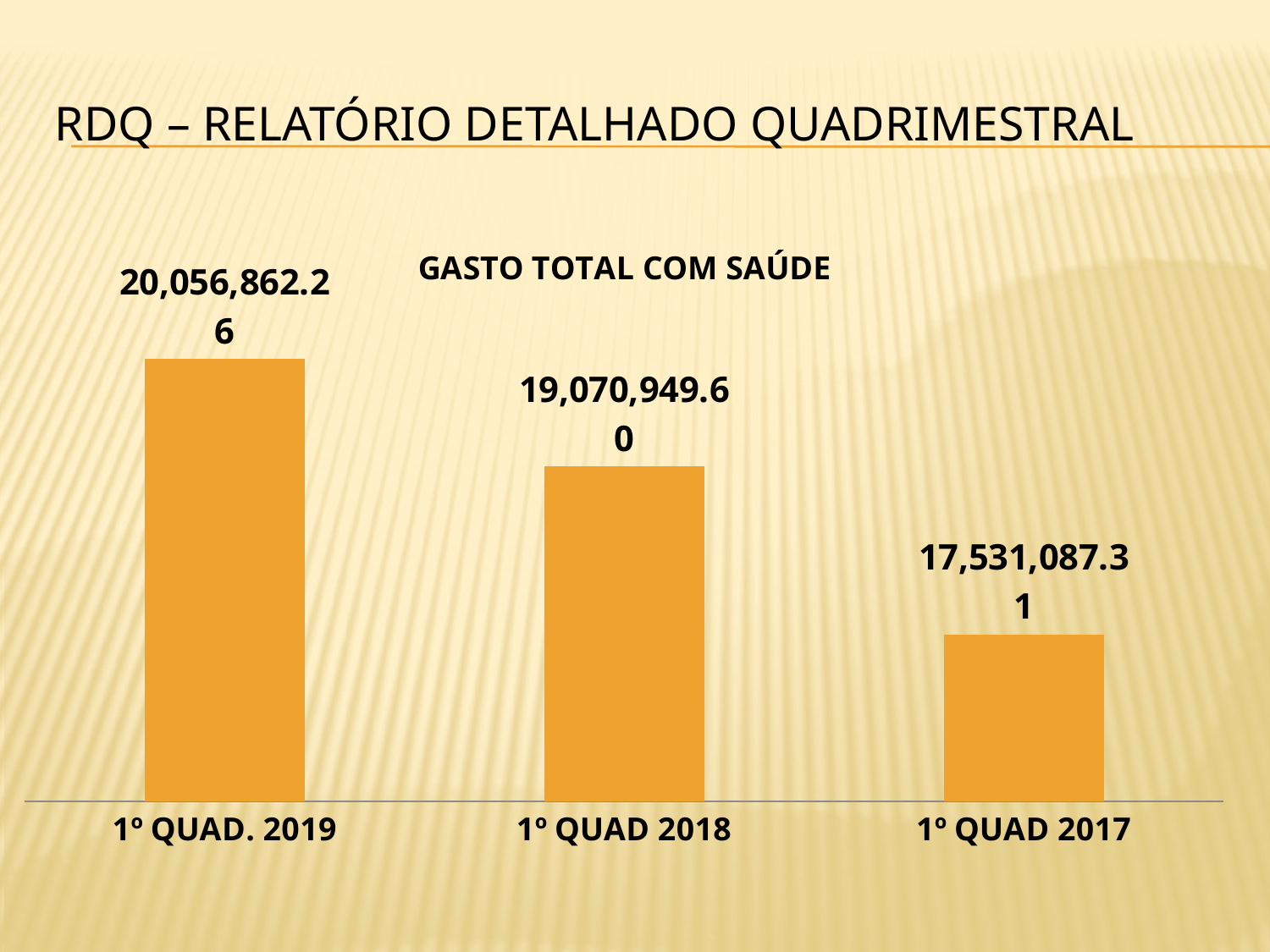
How many categories are shown in the chart? 3 What kind of chart is shown on the slide? Bar chart Which is larger, the value for 1º QUAD 2018 or 1º QUAD 2017? 1º QUAD 2018 What is the value for 1º QUAD 2017? 17,531,087.31 What is the difference between the values for 1º QUAD 2018 and 1º QUAD 2017? 1,539,862.29 Which category has the highest value? 1º QUAD. 2019 Which category has the lowest value? 1º QUAD 2017 What is the difference between the values for 1º QUAD. 2019 and 1º QUAD 2017? 2,525,774.95 What is the value for 1º QUAD. 2019? 20,056,862.26 What is the value for 1º QUAD 2018? 19,070,949.60 What is the title of the chart? GASTO TOTAL COM SAÚDE What is the difference between the values for 1º QUAD. 2019 and 1º QUAD 2018? 985,912.66